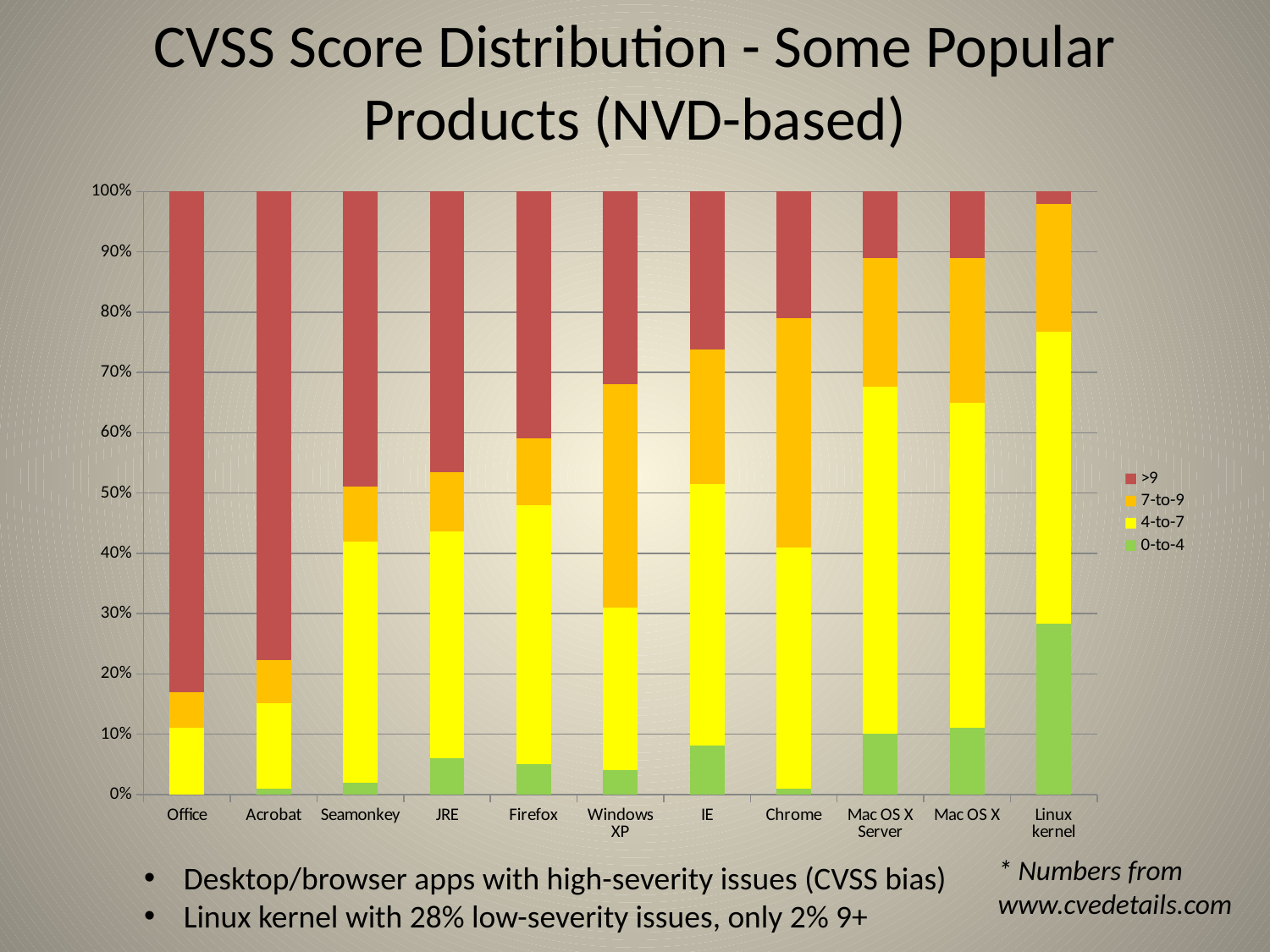
Is the share of 0-to-4 issues for IE greater or less than 10%? less What are the four CVSS score ranges listed in the legend? >9, 7-to-9, 4-to-7, 0-to-4 Which product has the smallest share of >9 (red) issues? Linux kernel What kind of chart is shown on the slide? Stacked bar chart How many series does the chart's legend list? 4 Moving from Office on the left to Linux kernel on the right, does the share of >9 issues generally rise or fall? fall How many products are shown along the x axis of the chart? 11 Which product has the largest share of >9 (red) issues? Office Is the share of 7-to-9 issues for Windows XP greater or less than 30%? greater Is the share of >9 issues for Office greater or less than 80%? greater Which product has the largest share of 0-to-4 (green) issues? Linux kernel Which has a larger share of 0-to-4 issues, Linux kernel or Mac OS X? Linux kernel